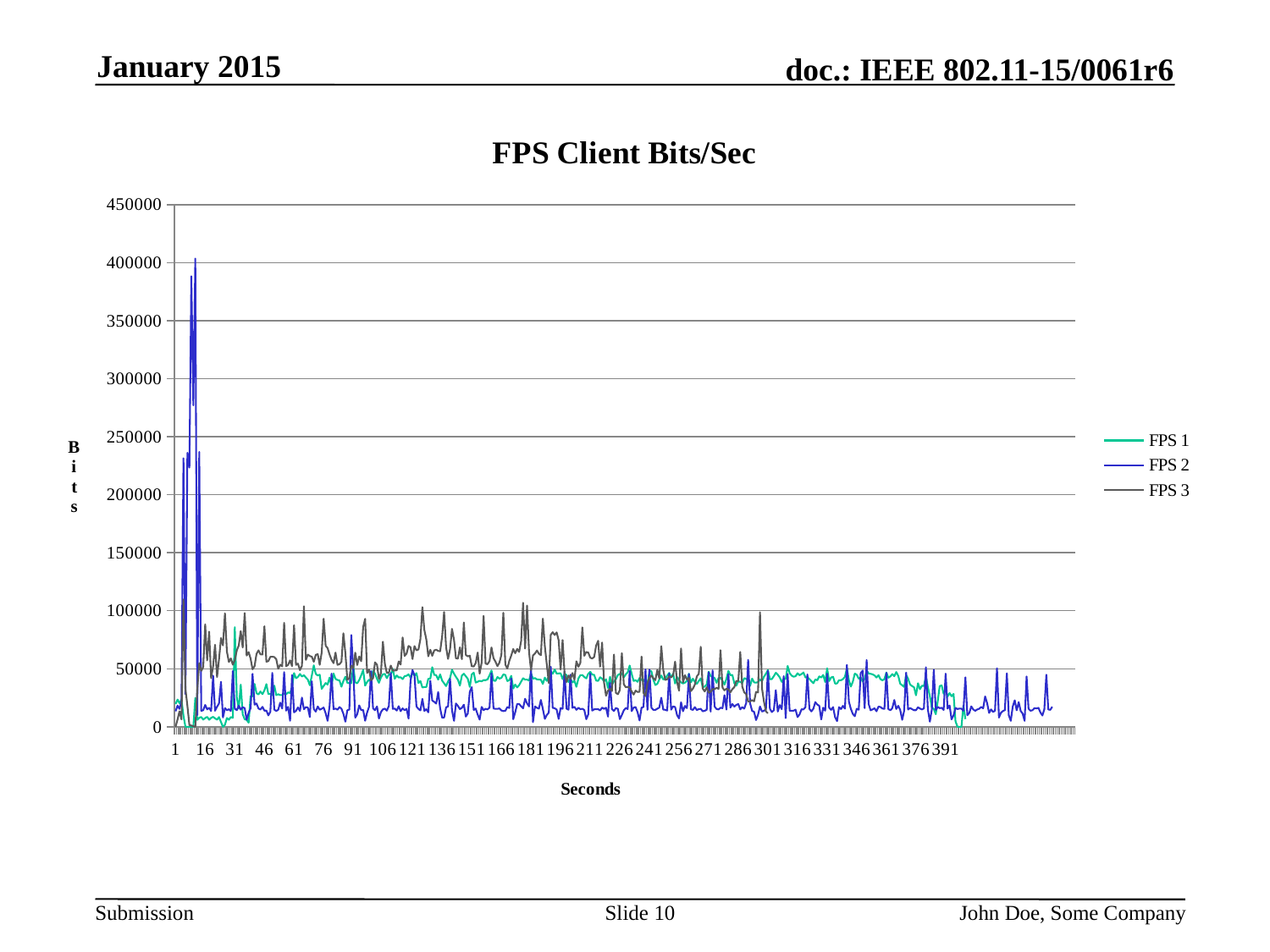
Is the value for FPS 2 at second 391 greater or less than 100000? less What kind of chart is shown on the slide? line chart Between seconds 106 and 196, which series is generally higher, FPS 3 or FPS 2? FPS 3 Is the peak value of FPS 3 greater or less than 300000? less What is the title of the chart? FPS Client Bits/Sec How many series does the legend list? 3 Is the peak value of FPS 2 greater or less than 350000? greater What is the label of the horizontal axis? Seconds Which series reaches the highest peak value on the chart? FPS 2